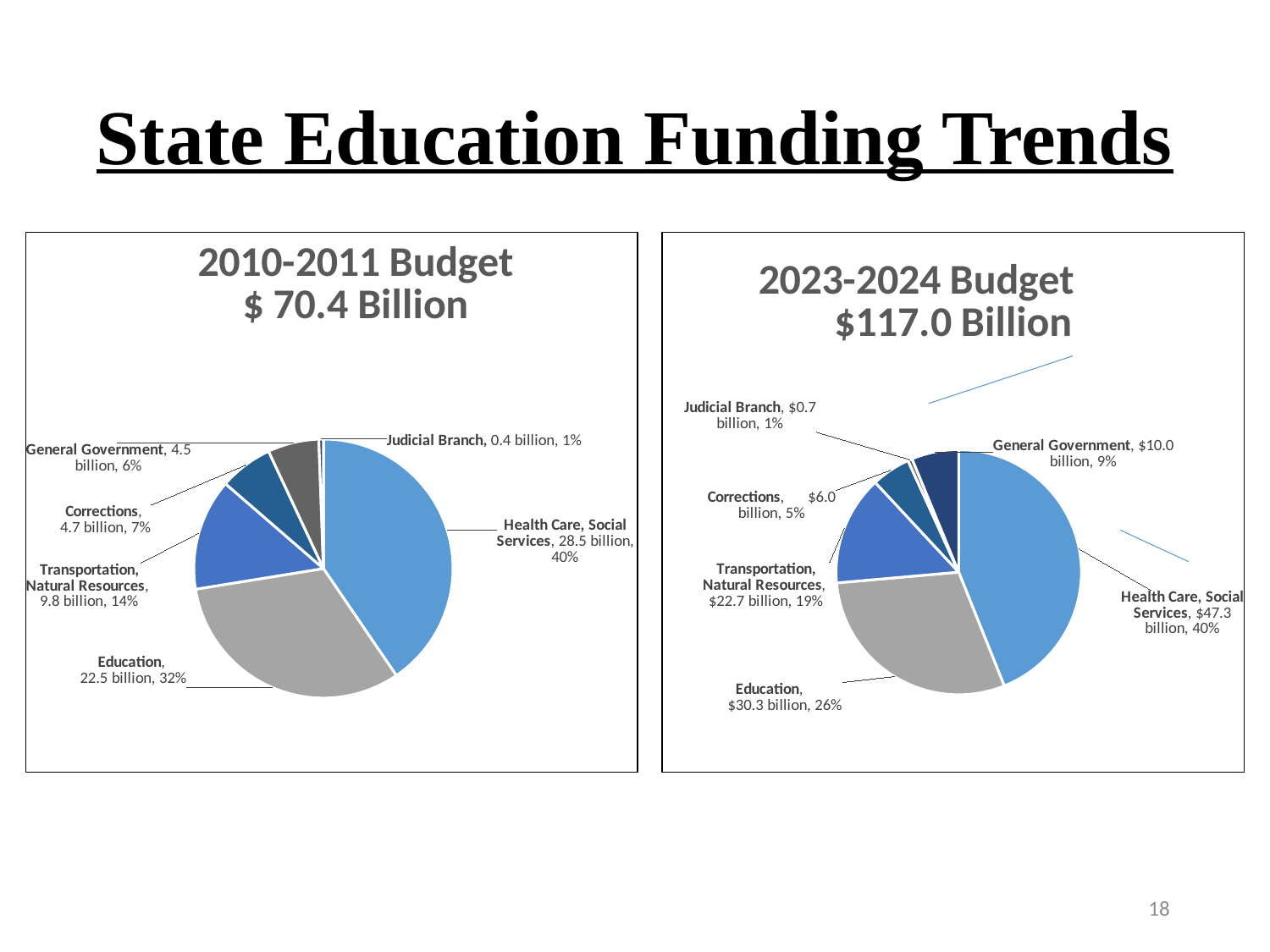
In the 2023-2024 Budget chart, which category has the smallest slice? Judicial Branch In the 2023-2024 Budget chart, what share of the pie does Transportation, Natural Resources represent? 19% In the 2010-2011 Budget chart, which is larger, Transportation, Natural Resources or General Government? Transportation, Natural Resources What kind of chart is the 2010-2011 Budget chart? Pie chart What total budget is stated in the title of the 2023-2024 Budget chart? $117.0 Billion In the 2010-2011 Budget chart, what share of the pie does Education represent? 32% How many categories are shown in the 2023-2024 Budget chart? 6 In the 2023-2024 Budget chart, what is the value for Education? $30.3 billion In the 2010-2011 Budget chart, what is the value for Corrections? 4.7 billion In the 2010-2011 Budget chart, which category has the largest slice? Health Care, Social Services In the 2023-2024 Budget chart, what is the difference between Health Care, Social Services and Education in billions? $17.0 billion In the 2023-2024 Budget chart, what share of the pie does General Government represent? 9%